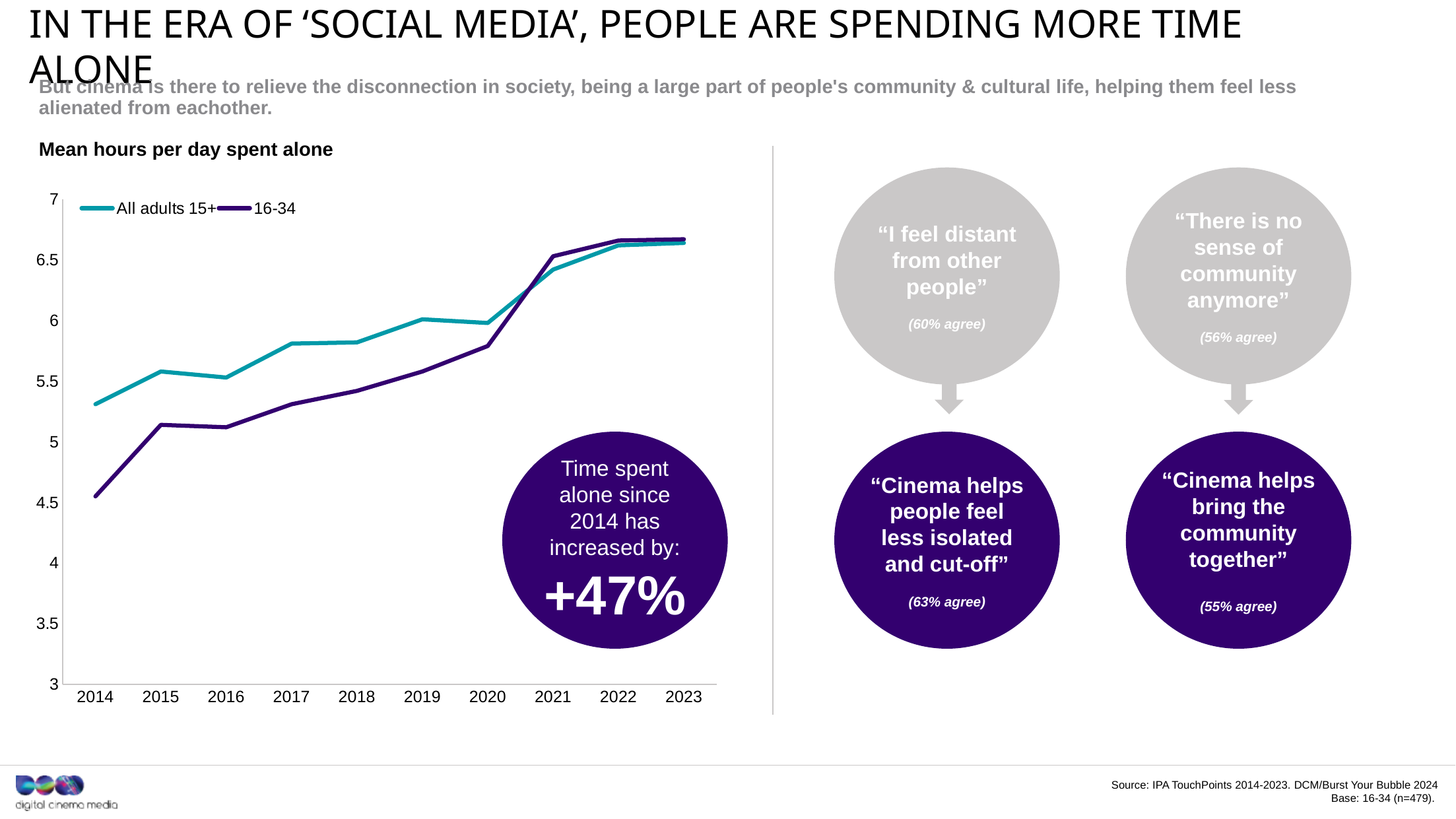
Is the value for 16-34 in 2014 greater or less than 5? less Do the values for 16-34 generally rise or fall from 2014 to 2023? rise Is the value for 16-34 in 2020 greater or less than 6? less In 2021, which series has the higher value, All adults 15+ or 16-34? 16-34 How many series does the chart legend list? 2 What kind of chart is shown on the slide? line chart In 2014, which series has the higher value, All adults 15+ or 16-34? All adults 15+ How many years are plotted along the x axis of the chart? 10 Is the value for All adults 15+ in 2014 greater or less than 5? greater In which year is the 16-34 series at its lowest? 2014